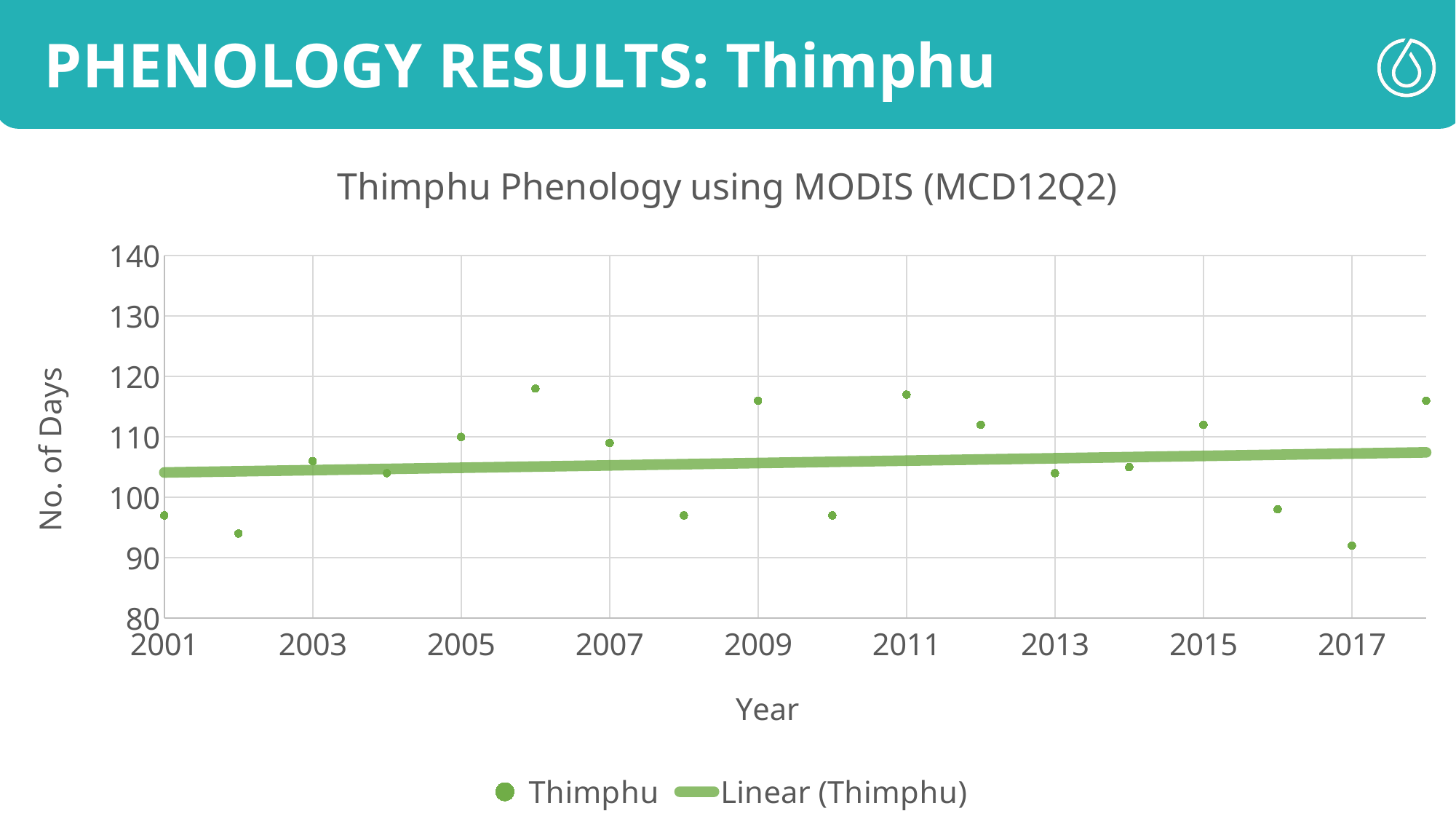
How many series does the legend list? 2 What kind of chart is shown on the slide? Scatter chart Does the linear trendline rise or fall from 2001 to 2018? Rises Which year has the larger value, 2006 or 2002? 2006 Is the value for 2003 greater or less than 100? greater Is the value for 2002 greater or less than 100? less Which year has the larger value, 2008 or 2005? 2005 Is the value for 2017 greater or less than 100? less What is the title of the chart? Thimphu Phenology using MODIS (MCD12Q2) What is the label of the y axis? No. of Days